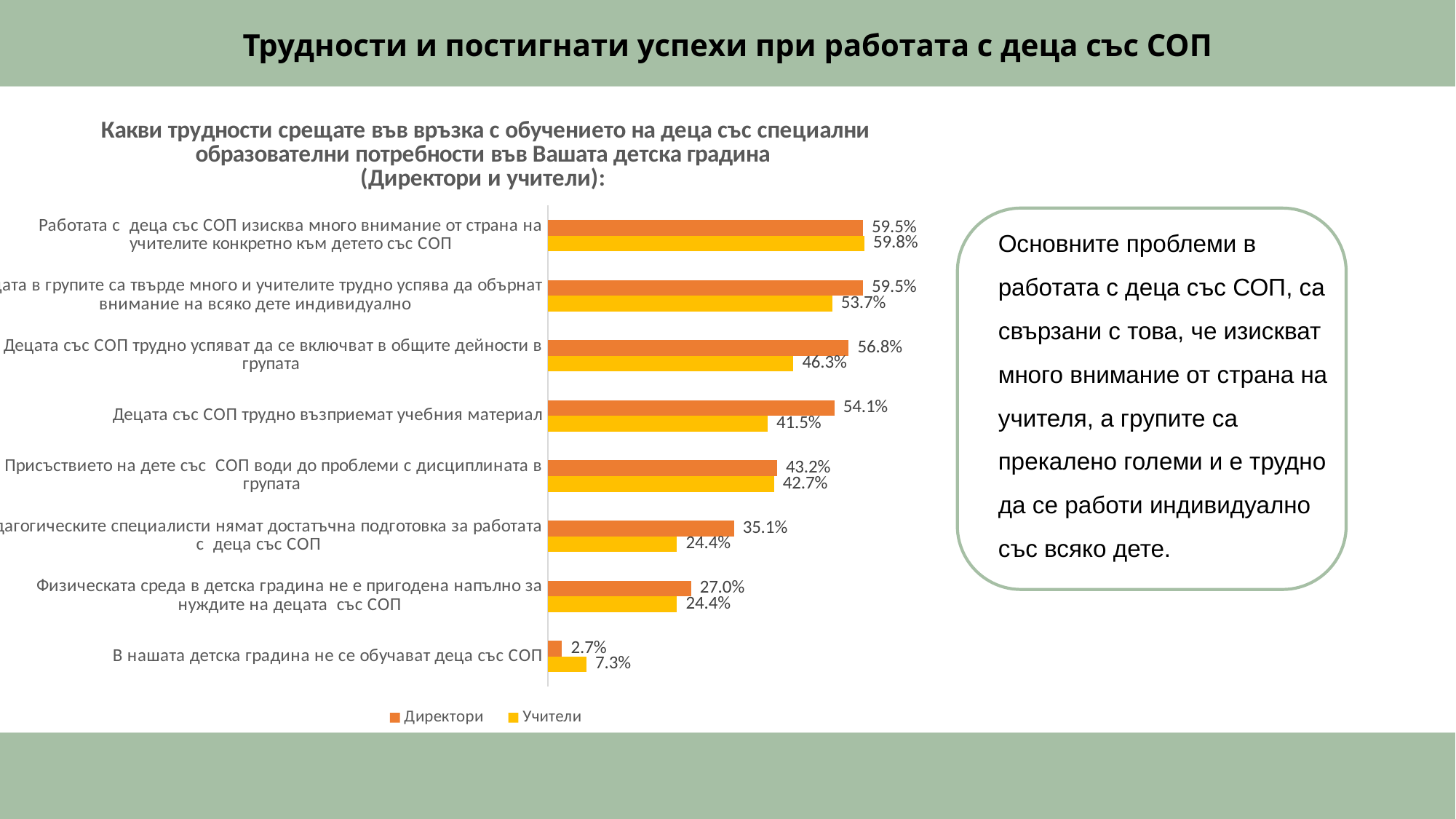
What kind of chart is shown on the slide? bar chart What is the difference between the Директори and Учители values for 'Децата със СОП трудно възприемат учебния материал'? 12.6% What is the value for Директори for 'В нашата детска градина не се обучават деца със СОП'? 2.7% How many categories are plotted in the chart? 8 For 'В нашата детска градина не се обучават деца със СОП', which is larger: the Директори value or the Учители value? Учители What is the value for Директори for 'Децата със СОП трудно възприемат учебния материал'? 54.1% Which category has the lowest value for Директори? В нашата детска градина не се обучават деца със СОП What is the value for Учители for 'Децата със СОП трудно успяват да се включват в общите дейности в групата'? 46.3% How many series does the chart legend list? 2 Which category has the highest value for Учители? Работата с деца със СОП изисква много внимание от страна на учителите конкретно към детето със СОП Which series is shown in orange in the chart legend? Директори What is the value for Учители for 'Работата с деца със СОП изисква много внимание от страна на учителите конкретно към детето със СОП'? 59.8%